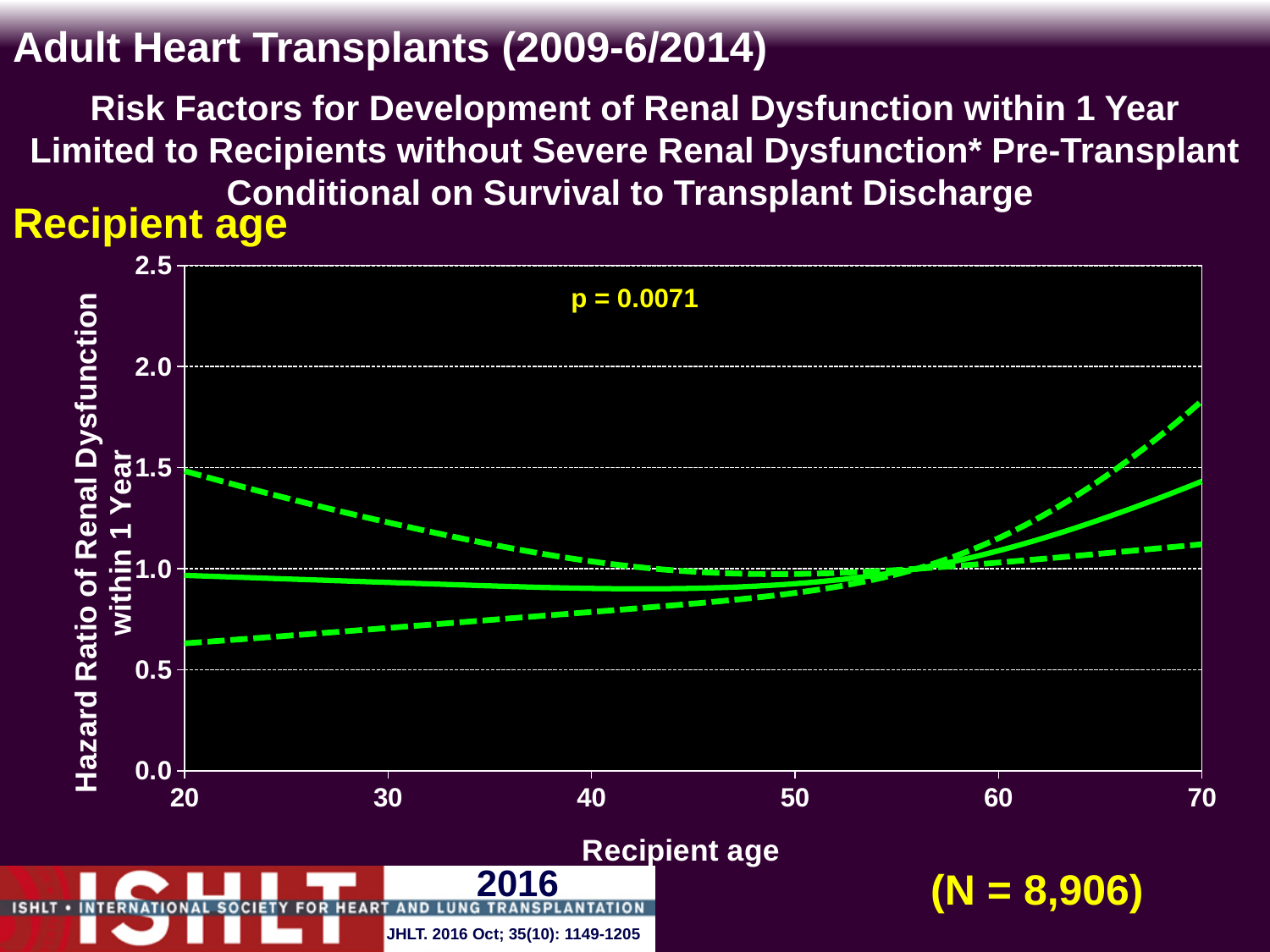
What is the label of the y axis? Hazard Ratio of Renal Dysfunction within 1 Year Is the solid line's hazard ratio at recipient age 20 greater or less than 1.0? less What is the highest value shown on the y axis? 2.5 Is the lower dashed line's value at recipient age 20 greater or less than 0.5? greater What is the sample size (N) shown on the slide? N = 8,906 What is the label of the x axis? Recipient age Is the upper dashed line's value at recipient age 70 greater or less than 1.5? greater What kind of chart is shown on the slide? line chart How many lines are plotted on the chart? 3 Does the solid hazard ratio line rise or fall between recipient age 50 and 70? rise What p-value is printed on the chart? p = 0.0071